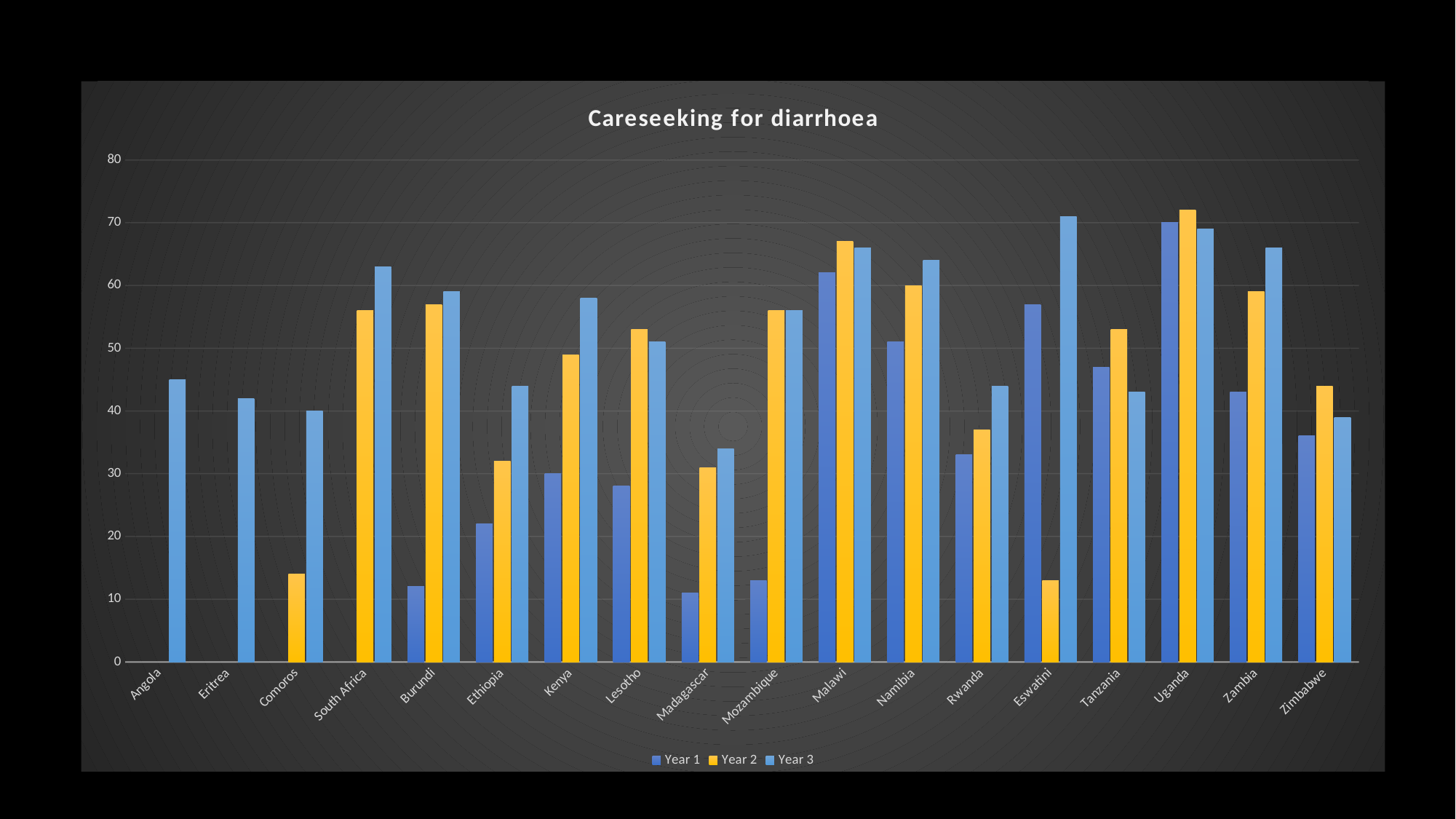
Is the Year 2 value for Eswatini greater or less than 20? less What kind of chart is shown on the slide? bar chart How many countries are shown on the x axis? 18 How many series does the legend list? 3 For Kenya, do the values rise or fall from Year 1 to Year 3? rise Is the Year 3 value for Angola greater or less than 40? greater Is the Year 1 value for Burundi greater or less than 20? less Which country has the highest Year 2 value? Uganda For Eswatini, which is larger: the Year 1 value or the Year 2 value? Year 1 What is the title of the chart? Careseeking for diarrhoea Which country has the highest Year 1 value? Uganda